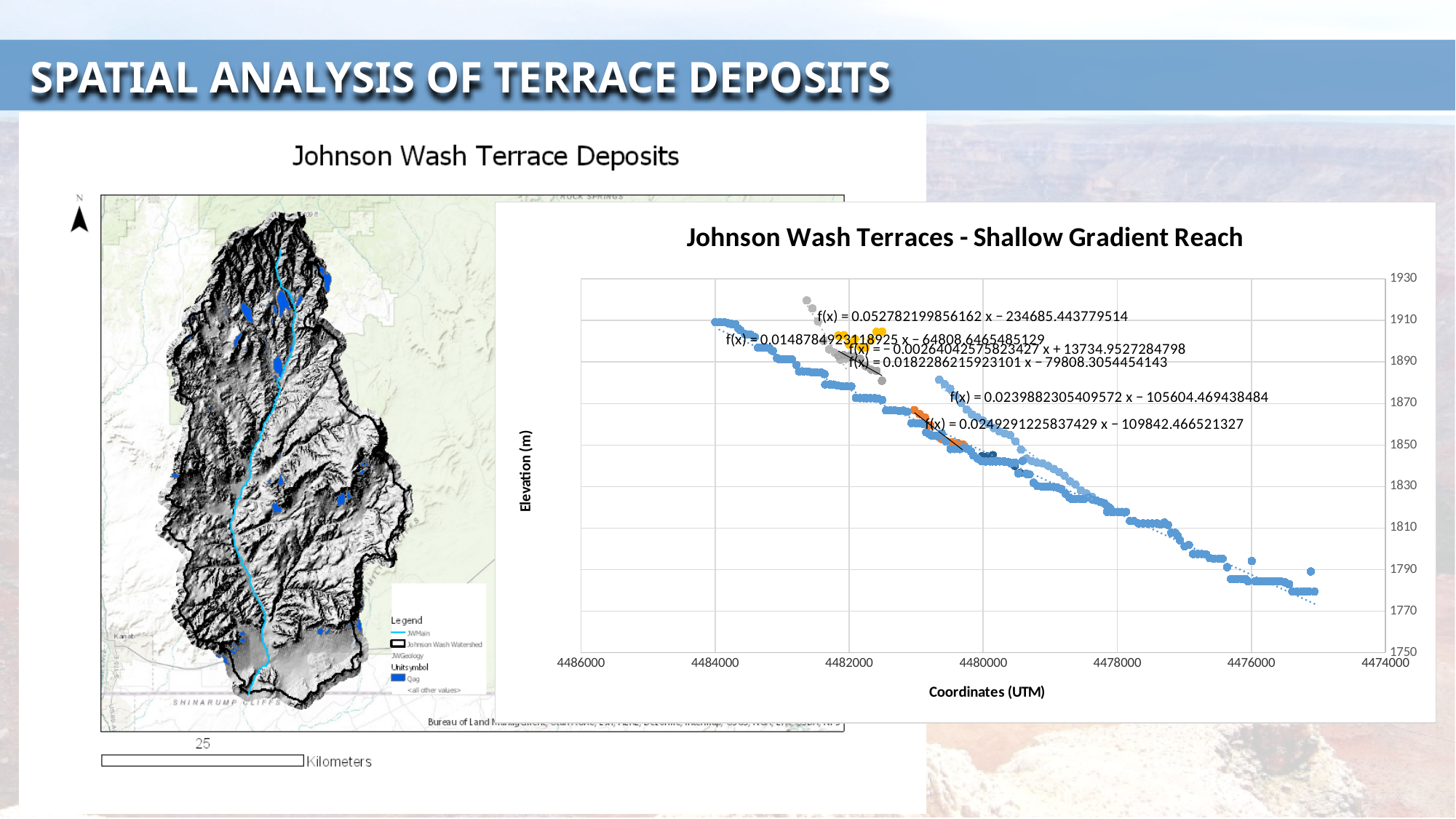
In the "Johnson Wash Terraces - Shallow Gradient Reach" chart, do the plotted elevations rise or fall moving from left to right along the x axis? fall In the "Johnson Wash Terraces - Shallow Gradient Reach" chart, what is the highest value shown on the elevation axis? 1930 In the "Johnson Wash Terraces - Shallow Gradient Reach" chart, what is the leftmost tick value on the Coordinates (UTM) axis? 4486000 In the "Johnson Wash Terraces - Shallow Gradient Reach" chart, what is the slope in the trendline equation f(x) = 0.052782199856162 x − 234685.443779514? 0.052782199856162 What is the title of the chart on the right side of the slide? Johnson Wash Terraces - Shallow Gradient Reach In the "Johnson Wash Terraces - Shallow Gradient Reach" chart, is the elevation of the highest plotted points near coordinate 4482000 greater or less than 1910? greater In the "Johnson Wash Terraces - Shallow Gradient Reach" chart, are the plotted points near coordinate 4484000 greater or less than 1890 in elevation? greater In the "Johnson Wash Terraces - Shallow Gradient Reach" chart, how many trendline equations are printed on the plot? 6 What kind of chart is "Johnson Wash Terraces - Shallow Gradient Reach"? scatter chart In the "Johnson Wash Terraces - Shallow Gradient Reach" chart, is the elevation of the lowest plotted points near coordinate 4475000 greater or less than 1790? less In the "Johnson Wash Terraces - Shallow Gradient Reach" chart, what is the label of the vertical axis? Elevation (m) In the "Johnson Wash Terraces - Shallow Gradient Reach" chart, what is the lowest value shown on the elevation axis? 1750